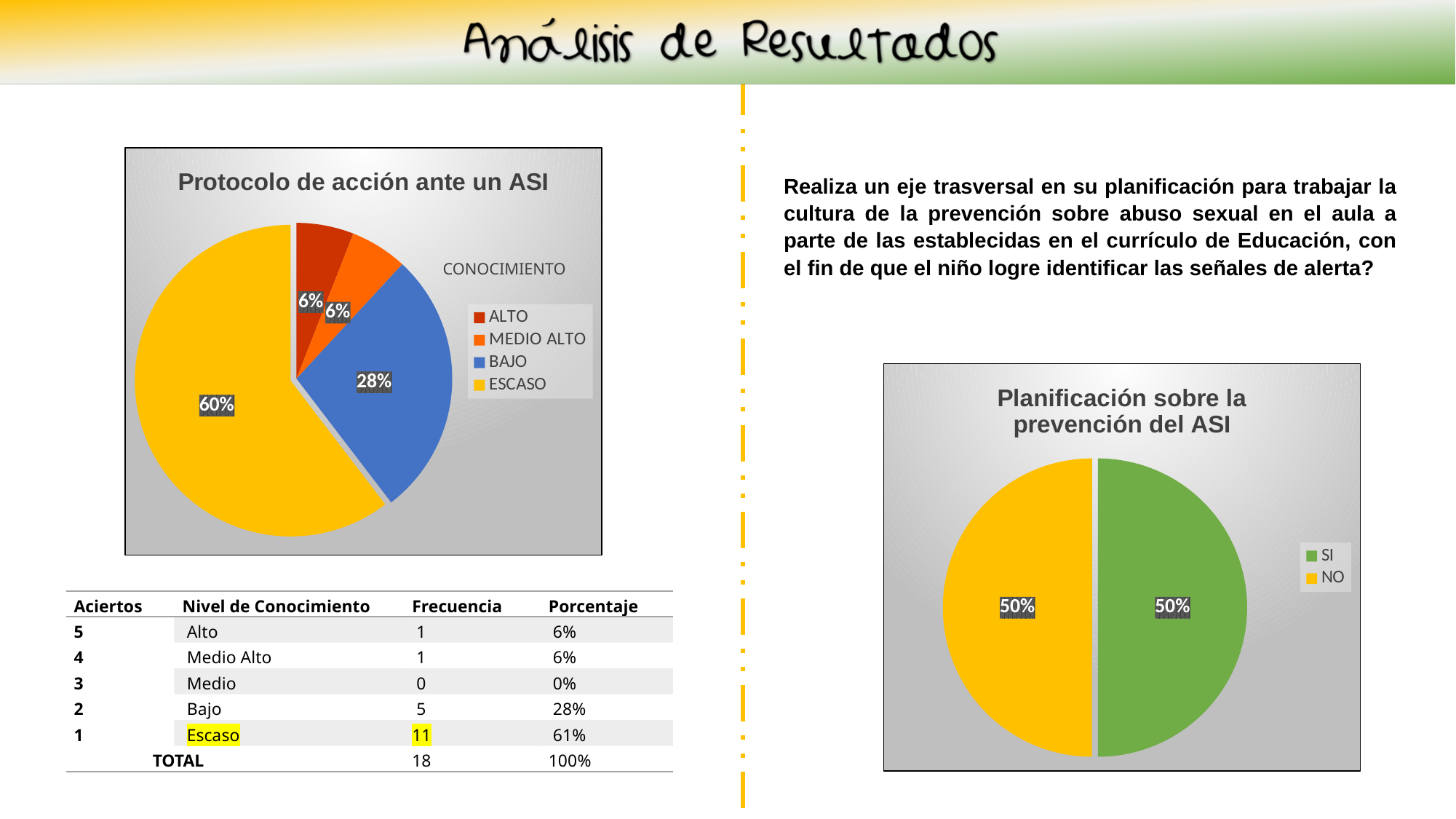
In the chart titled "Planificación sobre la prevención del ASI", what colour is the SI slice? Green In the chart titled "Protocolo de acción ante un ASI", what percentage is shown for the ESCASO slice? 60% How many categories does the legend of the chart titled "Protocolo de acción ante un ASI" list? 4 In the chart titled "Planificación sobre la prevención del ASI", what percentage is shown for SI? 50% What kind of chart is "Protocolo de acción ante un ASI"? Pie chart In the chart titled "Protocolo de acción ante un ASI", what percentage is shown for the ALTO slice? 6% In the chart titled "Protocolo de acción ante un ASI", what is the difference in percentage points between the ESCASO and BAJO slices? 32 How many categories does the legend of the chart titled "Planificación sobre la prevención del ASI" list? 2 In the chart titled "Planificación sobre la prevención del ASI", what percentage is shown for NO? 50% In the chart titled "Protocolo de acción ante un ASI", which category has the largest slice? ESCASO In the chart titled "Protocolo de acción ante un ASI", what percentage is shown for the BAJO slice? 28% In the chart titled "Protocolo de acción ante un ASI", which slice is larger, BAJO or MEDIO ALTO? BAJO